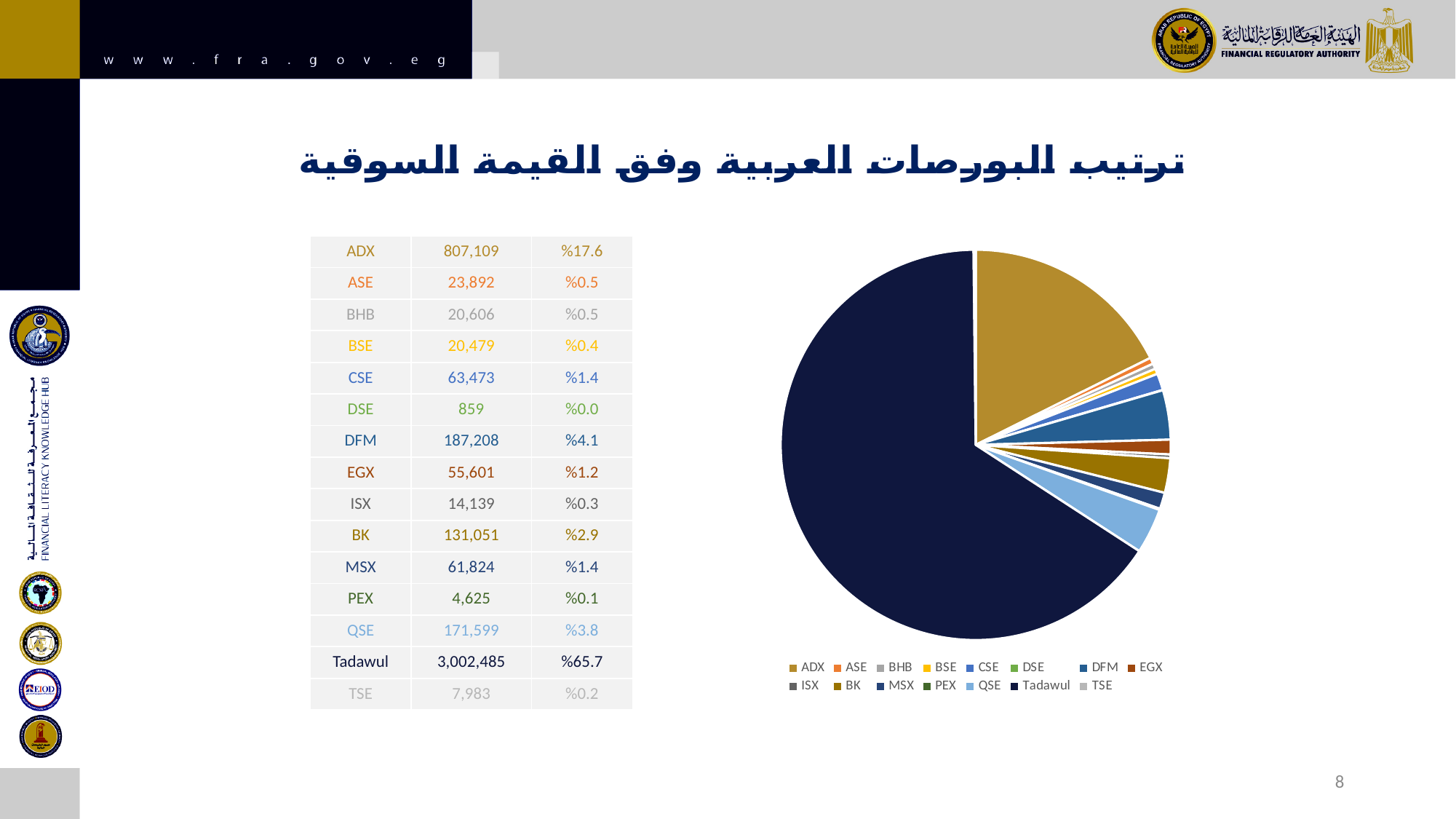
How many entries does the pie chart's legend list? 15 What is the market value listed for ADX in the table? 807,109 What kind of chart is shown on the slide? pie chart What is the market value listed for QSE in the table? 171,599 Which exchange has the smallest market value in the table? DSE What colour is the Tadawul slice in the pie chart? dark navy blue Which exchange has the largest slice of the pie chart? Tadawul How many exchanges are listed in the table? 15 Which has the larger market value, DFM or QSE? DFM What share of the pie does Tadawul hold, according to the table? %65.7 What share of the pie does ADX hold, according to the table? %17.6 What is the difference between the market values of Tadawul and ADX? 2,195,376